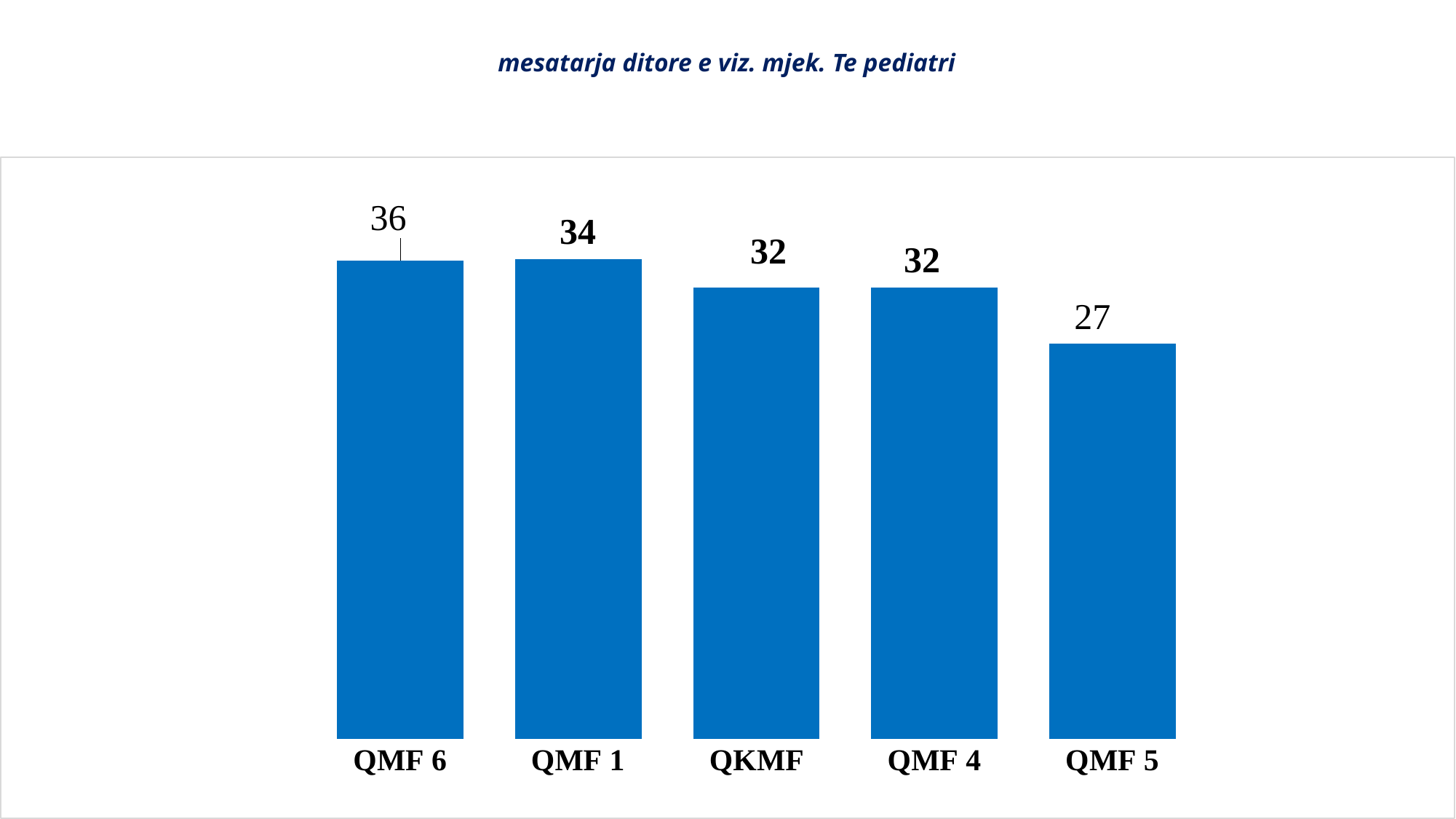
Which is larger, the value for QMF 1 or the value for QMF 5? QMF 1 What is the value for QKMF? 32 What is the value for QMF 6? 36 Which category has the lowest value? QMF 5 What is the title of the chart? mesatarja ditore e viz. mjek. Te pediatri What kind of chart is shown on the slide? Bar chart What is the difference between the values for QMF 1 and QMF 4? 2 What is the value for QMF 1? 34 How many categories are shown in the chart? 5 What is the value for QMF 5? 27 Which category has the highest value? QMF 6 What is the difference between the values for QMF 6 and QMF 5? 9